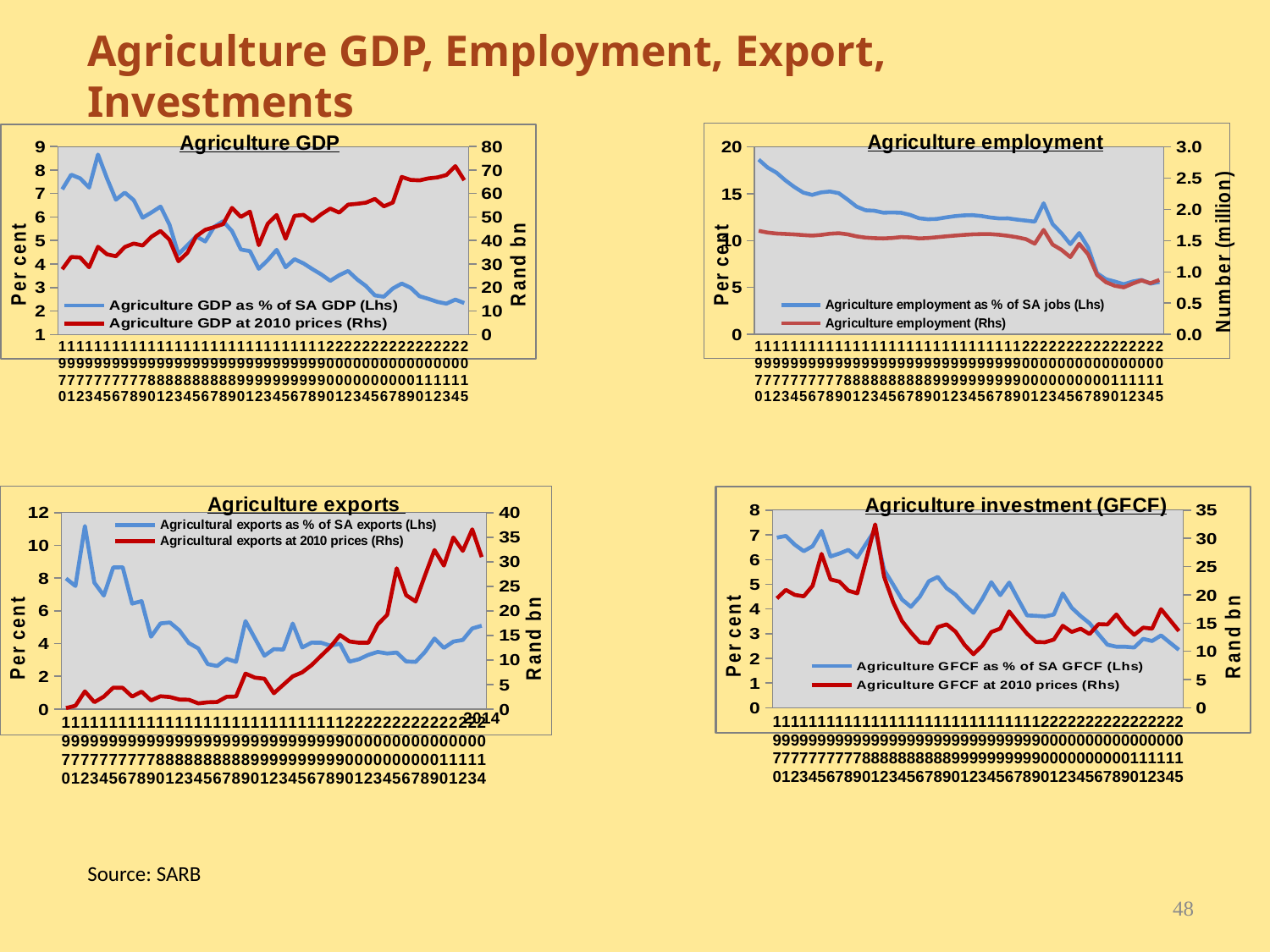
In the 'Agriculture exports' chart, does the 'Agricultural exports at 2010 prices (Rhs)' line rise or fall overall from left to right? Rise In the 'Agriculture GDP' chart, does the 'Agriculture GDP as % of SA GDP (Lhs)' line rise or fall overall from left to right? Fall In the 'Agriculture employment' chart, does the 'Agriculture employment as % of SA jobs (Lhs)' line rise or fall overall from left to right? Fall In the 'Agriculture employment' chart, is the first value of 'Agriculture employment as % of SA jobs (Lhs)' greater or less than 15? greater In the 'Agriculture exports' chart, is the peak value of 'Agricultural exports as % of SA exports (Lhs)' greater or less than 10? greater What kind of chart is the 'Agriculture GDP' chart? Line chart How many series does the legend of the 'Agriculture employment' chart list? 2 What source is cited at the bottom of the slide? SARB How many charts are shown on the slide? 4 In the 'Agriculture investment (GFCF)' chart, is the peak value of 'Agriculture GFCF at 2010 prices (Rhs)' greater or less than 30? greater What is the label of the right-hand vertical axis of the 'Agriculture employment' chart? Number (million)